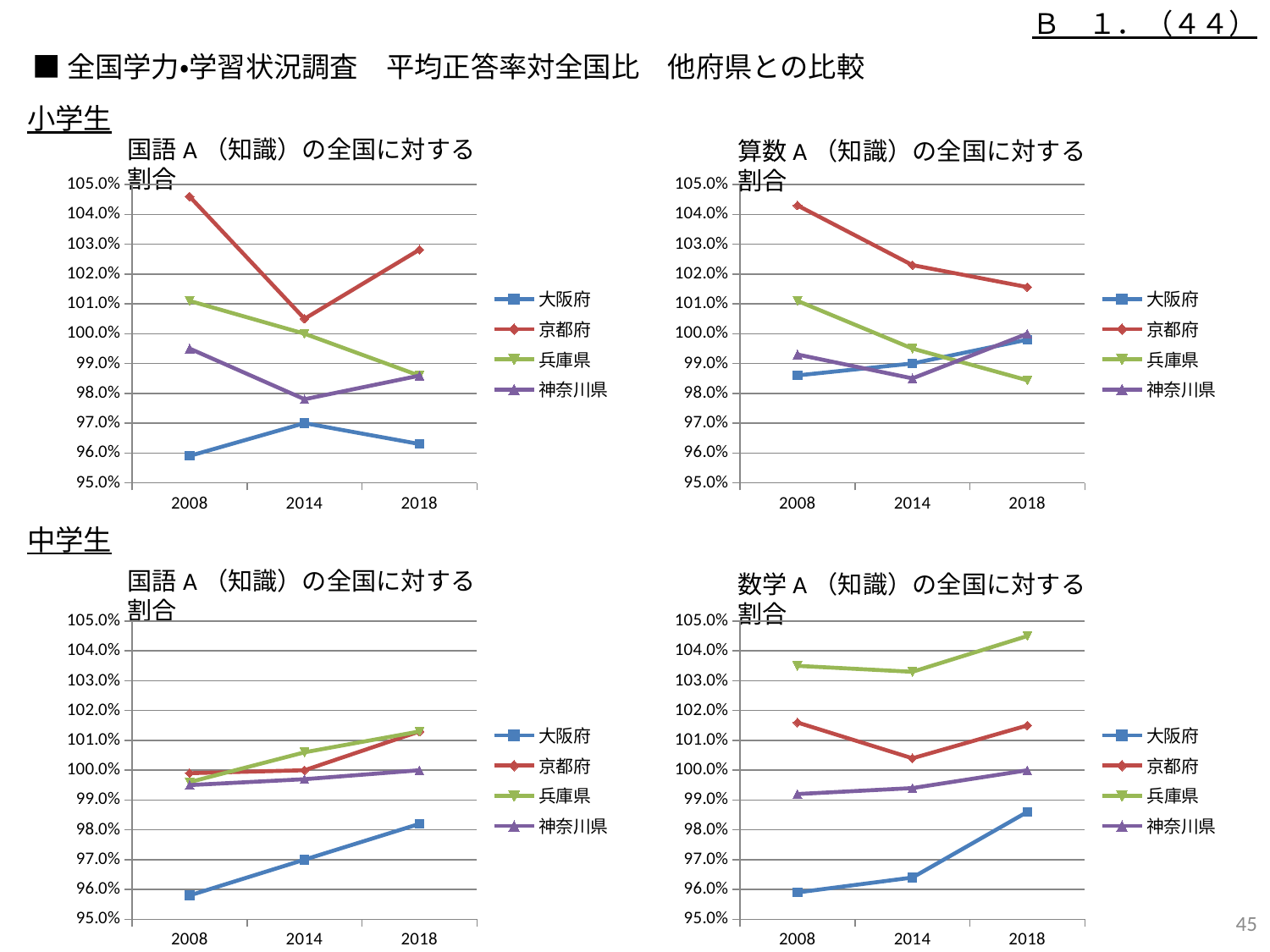
How many years are plotted on the x axis of the bottom-right chart (中学生 数学A)? 3 In the top-right chart (小学生 算数A), does the value for 京都府 rise or fall from 2008 to 2018? fall In the bottom-right chart (中学生 数学A), which prefecture has the highest value in 2018? 兵庫県 What is the title of the top-right chart? 算数A（知識）の全国に対する割合 In the bottom-left chart (中学生 国語A), does the value for 大阪府 rise or fall from 2008 to 2018? rise What kind of chart is the top-left chart (小学生 国語A)? line chart In the top-left chart (小学生 国語A), which prefecture has the lowest value in 2008? 大阪府 In the top-left chart (小学生 国語A), is the value for 京都府 in 2008 greater or less than 104.0%? greater How many series does the legend of the top-left chart (小学生 国語A) list? 4 In the bottom-right chart (中学生 数学A), is the value for 大阪府 in 2008 greater or less than 97.0%? less In the top-left chart (小学生 国語A), which prefecture has the highest value in 2008? 京都府 In the bottom-right chart (中学生 数学A), which is larger in 2018, 兵庫県 or 京都府? 兵庫県